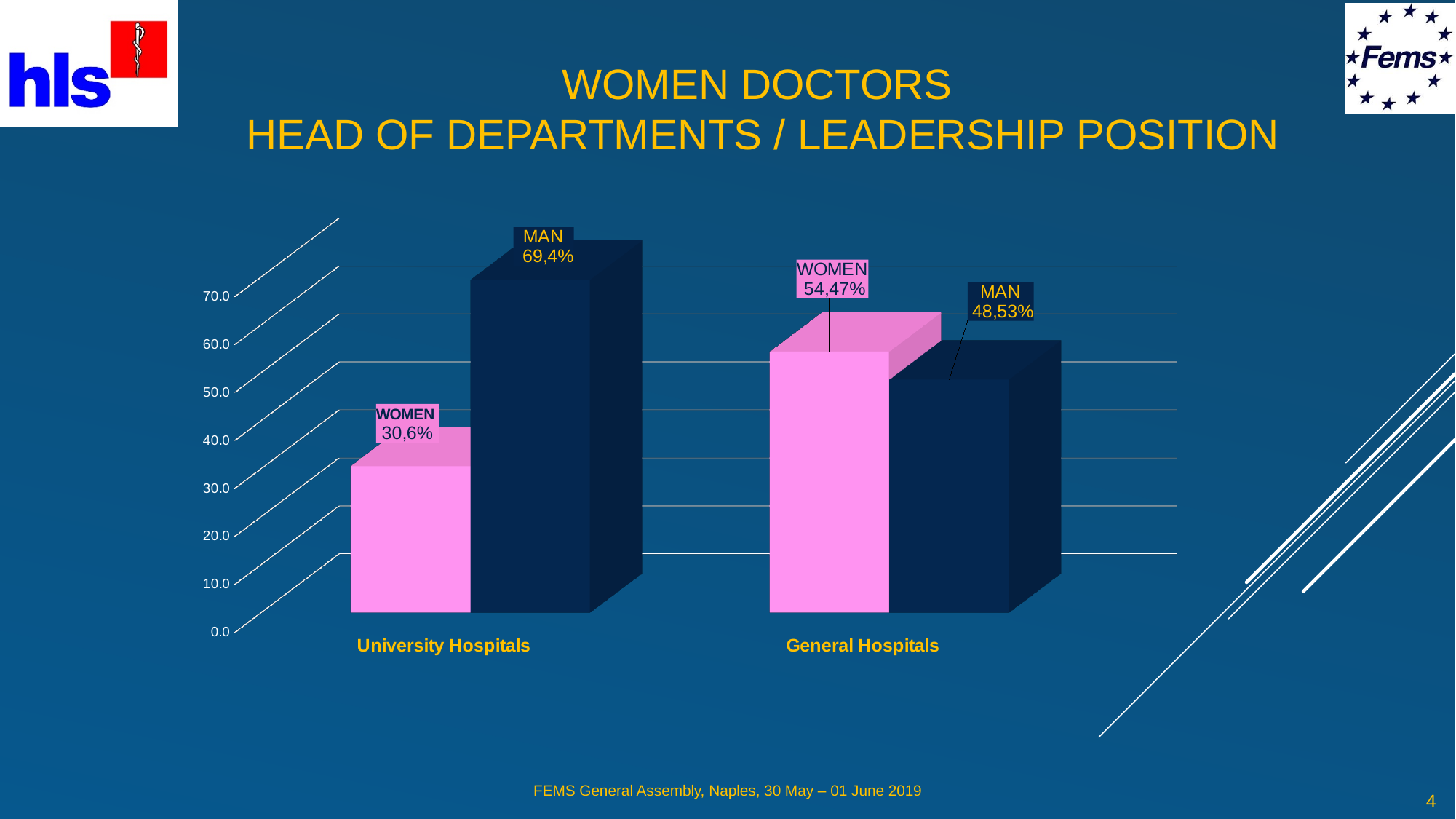
Is the value for WOMEN at University Hospitals greater or less than 40? less What is the value for WOMEN at General Hospitals? 54,47% Which bar has the lowest value in the chart? WOMEN at University Hospitals What is the difference between the WOMEN and MAN values at General Hospitals? 5,94% What is the value for MAN at University Hospitals? 69,4% At General Hospitals, which is larger, the WOMEN value or the MAN value? WOMEN Which bar has the highest value in the chart? MAN at University Hospitals What is the value for WOMEN at University Hospitals? 30,6% How many hospital categories are shown on the x axis? 2 What kind of chart is shown on the slide? Bar chart What is the value for MAN at General Hospitals? 48,53% What is the difference between the MAN and WOMEN values at University Hospitals? 38,8%